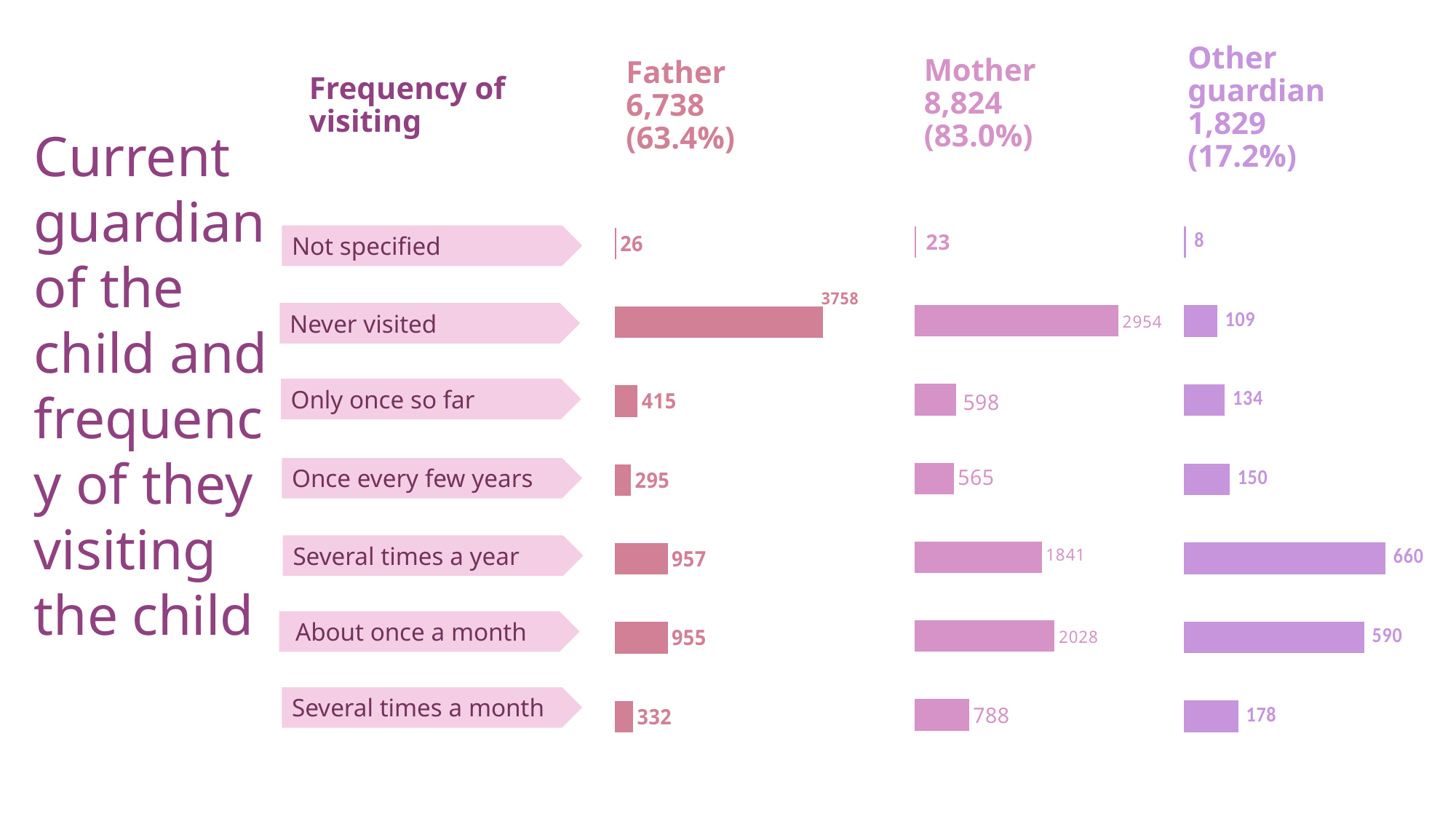
In the Mother chart, what is the value for About once a month? 2028 In the Other guardian chart, what is the value for Several times a year? 660 What kind of chart is the Mother chart? Bar chart In the Father chart, what is the difference between Never visited and Several times a year? 2801 In the Mother chart, which is larger: Only once so far or Several times a month? Several times a month How many frequency categories are shown in the Father chart? 7 In the Mother chart, which category has the highest value? Never visited In the Father chart, what is the value for Never visited? 3758 In the Other guardian chart, which category has the highest value? Several times a year In the Other guardian chart, which category has the lowest value? Not specified What total and percentage are shown in the heading of the Other guardian chart? 1,829 (17.2%) In the Mother chart, what is the difference between About once a month and Several times a year? 187